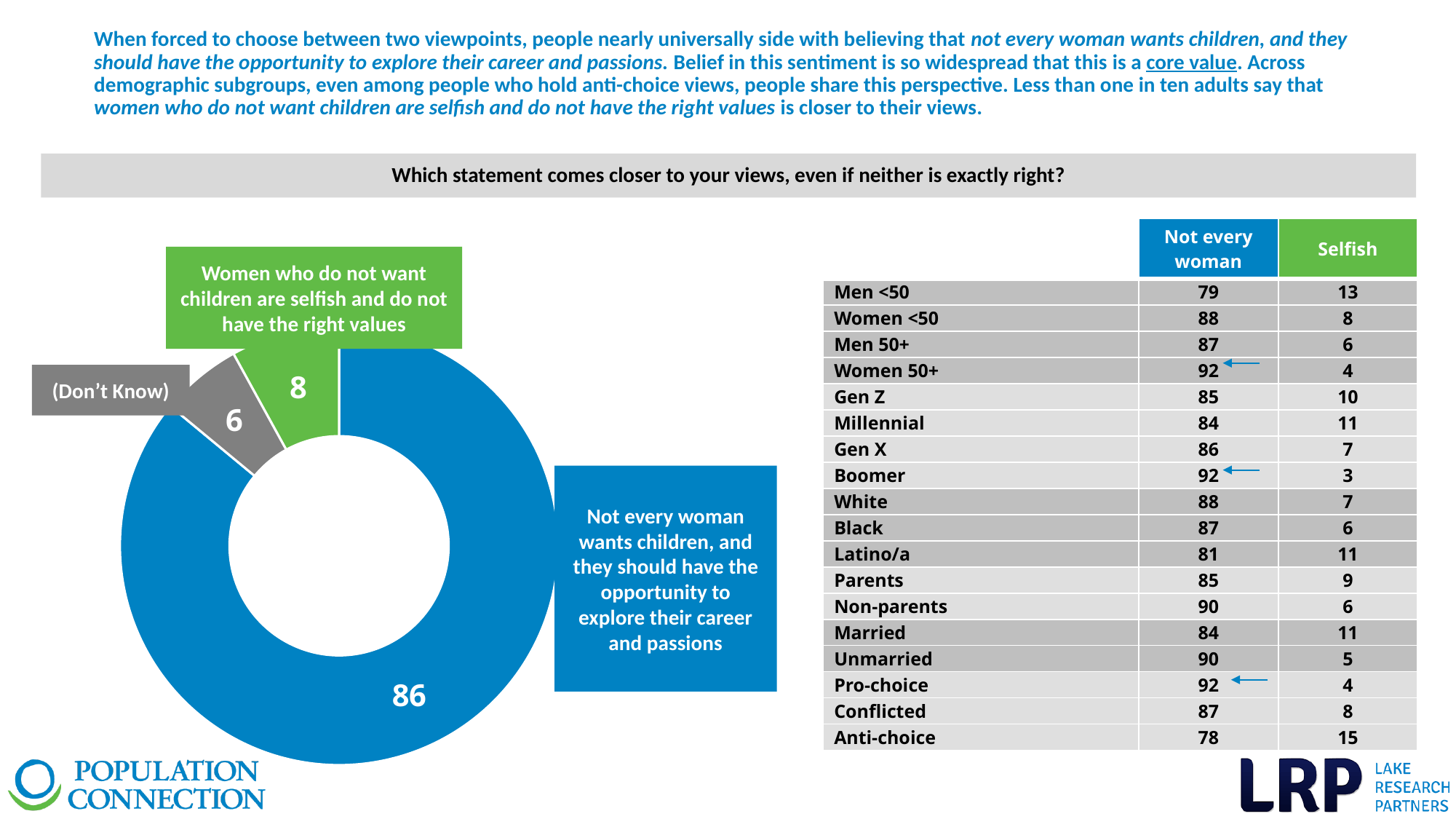
In the donut chart, which is larger: the 'Women who do not want children are selfish' slice or the '(Don't Know)' slice? Women who do not want children are selfish and do not have the right values In the donut chart, what value is shown for the slice 'Women who do not want children are selfish and do not have the right values'? 8 What colour is the largest slice of the donut chart? Blue In the donut chart, what value is shown for the slice 'Not every woman wants children, and they should have the opportunity to explore their career and passions'? 86 Which slice of the donut chart is the smallest? (Don't Know) How many slices does the donut chart have? 3 Which slice of the donut chart is the largest? Not every woman wants children, and they should have the opportunity to explore their career and passions What survey question is shown in the grey bar above the donut chart? Which statement comes closer to your views, even if neither is exactly right? In the donut chart, what is the difference between the 'Not every woman wants children' slice and the 'Women who do not want children are selfish' slice? 78 In the donut chart, what value is shown for the '(Don't Know)' slice? 6 What kind of chart is shown on the left of the slide? Pie chart (donut) What is the total of the three values shown in the donut chart? 100